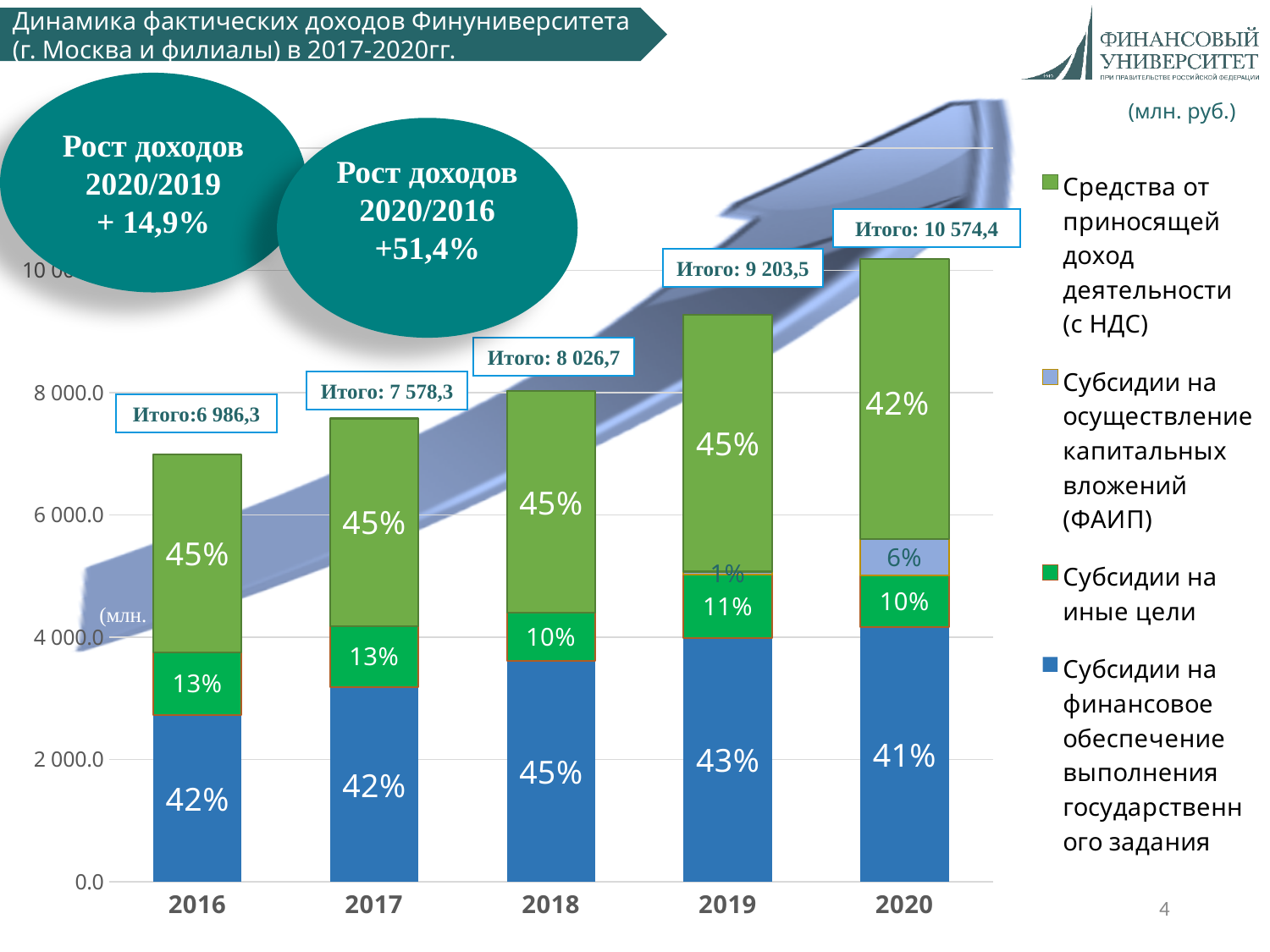
Which year has the lowest total income? 2016 What share of the 2016 bar is 'Субсидии на иные цели'? 13% What share of the 2020 bar is 'Субсидии на осуществление капитальных вложений (ФАИП)'? 6% Which year has the highest total income? 2020 What is the total (Итого) income shown for 2016? 6 986,3 How many years are shown on the x axis of the chart? 5 How many series does the chart legend list? 4 What share of the 2018 bar is 'Субсидии на финансовое обеспечение выполнения государственного задания'? 45% By how much does the 2020 total (Итого) exceed the 2019 total? 1 370,9 Do the total incomes rise or fall from 2016 to 2020? Rise What is the total (Итого) income shown for 2020? 10 574,4 What kind of chart is shown on the slide? Stacked bar chart